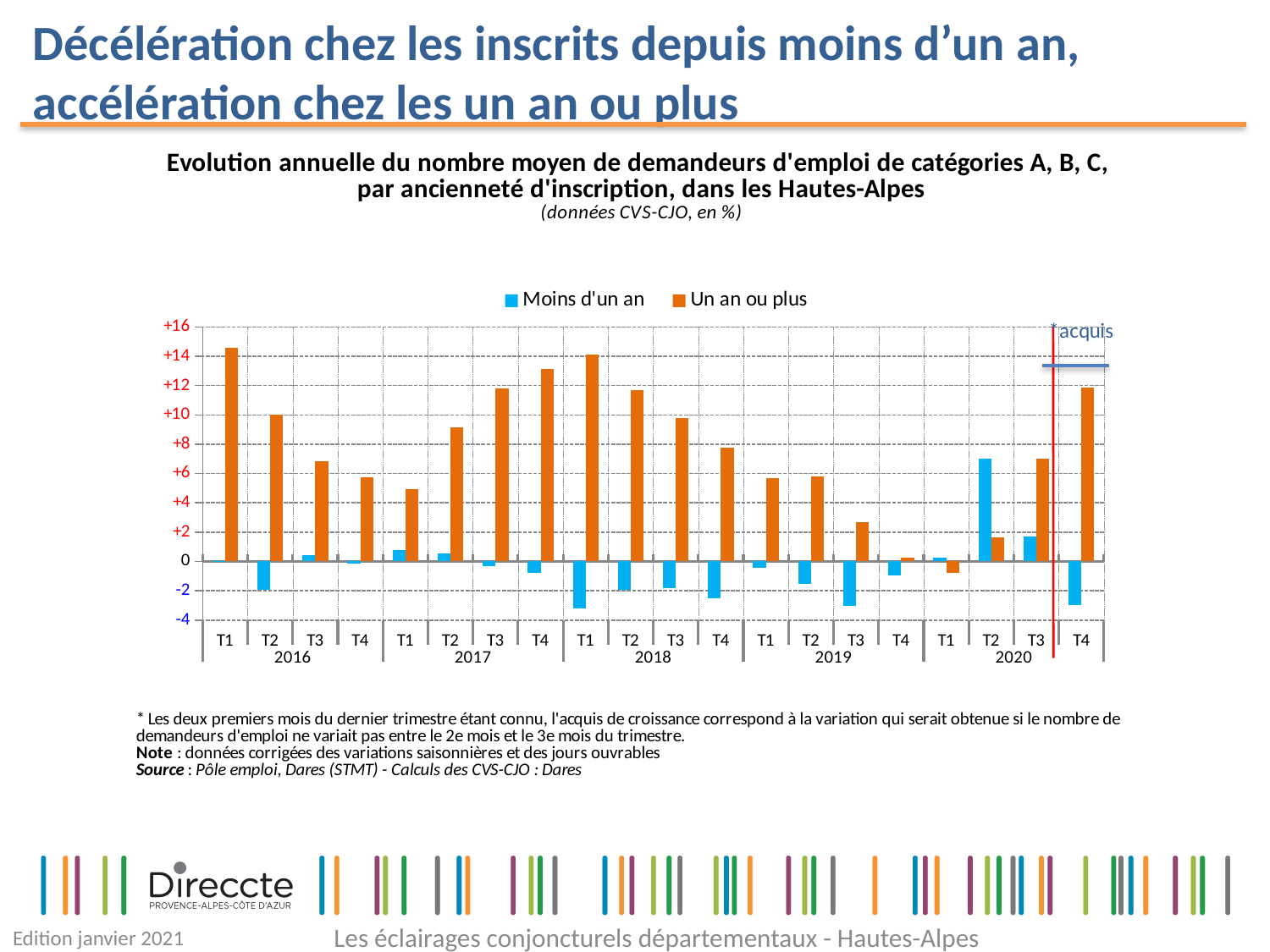
How many quarters are plotted along the x axis? 20 What colour represents the 'Moins d'un an' series in the legend? blue How many series does the legend list? 2 Is the value for 'Moins d'un an' in T1 2018 greater or less than -2? less Which quarter has the highest value for the 'Moins d'un an' series? T2 2020 Is the value for 'Un an ou plus' in T4 2017 greater or less than +12? greater Does the 'Un an ou plus' series rise or fall from T1 2018 to T1 2020? fall For the 'Un an ou plus' series, which is larger: T2 2016 or T3 2016? T2 2016 What kind of chart is shown on the slide? bar chart Which quarter has the lowest value for the 'Un an ou plus' series? T1 2020 Is the value for 'Un an ou plus' in T1 2016 greater or less than +14? greater